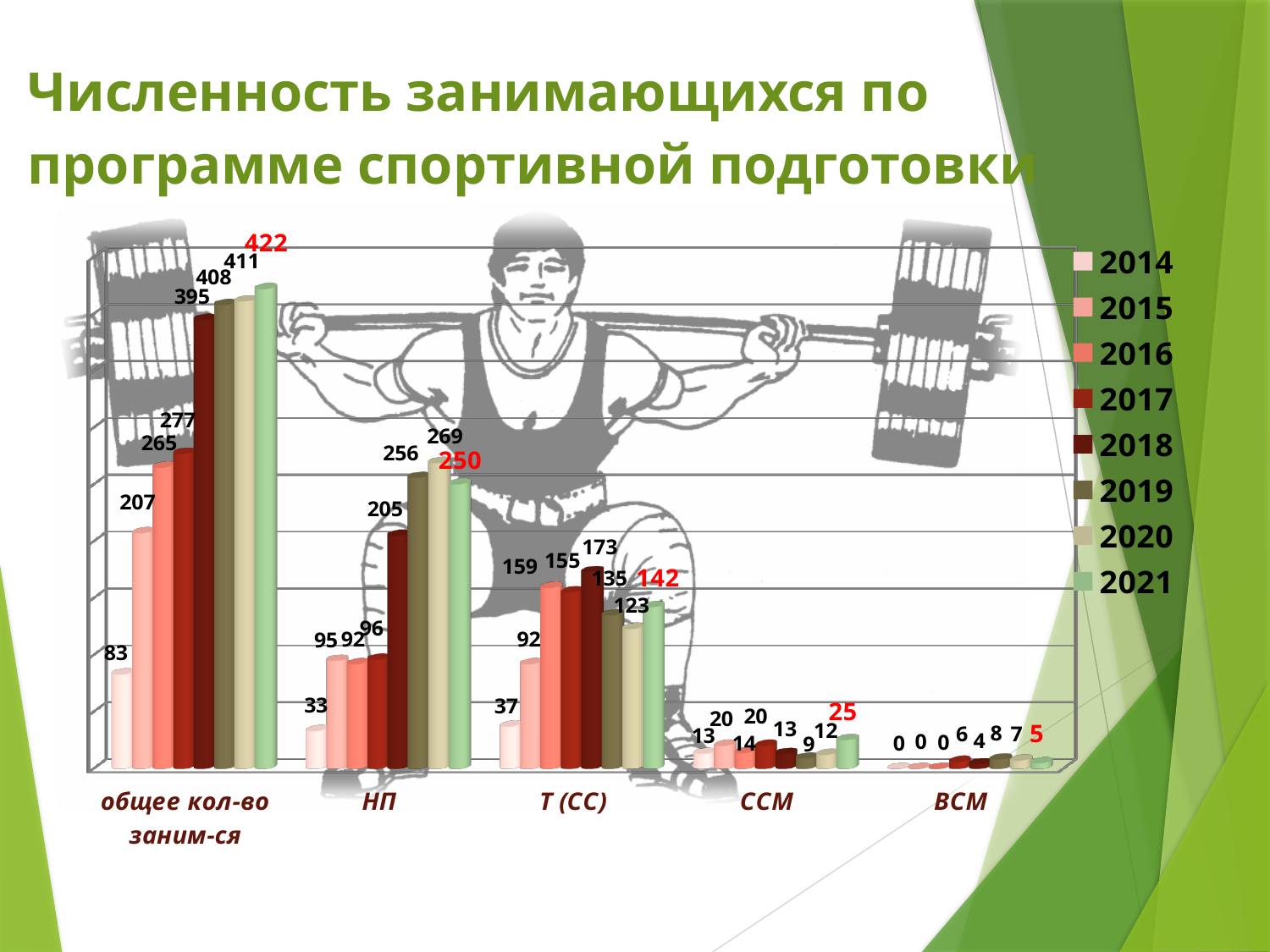
What is the value for 2018 in the 'Т (СС)' category? 173 Which year has the lowest value in the 'общее кол-во заним-ся' category? 2014 How many series does the legend list? 8 What is the value for 2014 in the 'ВСМ' category? 0 In the 'Т (СС)' category, which is larger: the value for 2016 or the value for 2020? 2016 What is the value for 2021 in the 'ССМ' category? 25 What kind of chart is shown on the slide? Bar chart How many categories are shown on the x axis of the chart? 5 What is the difference between the 2021 and 2014 values in the 'общее кол-во заним-ся' category? 339 What is the value for 2021 in the 'общее кол-во заним-ся' category? 422 Which year has the highest value in the 'НП' category? 2020 What is the value for 2014 in the 'НП' category? 33